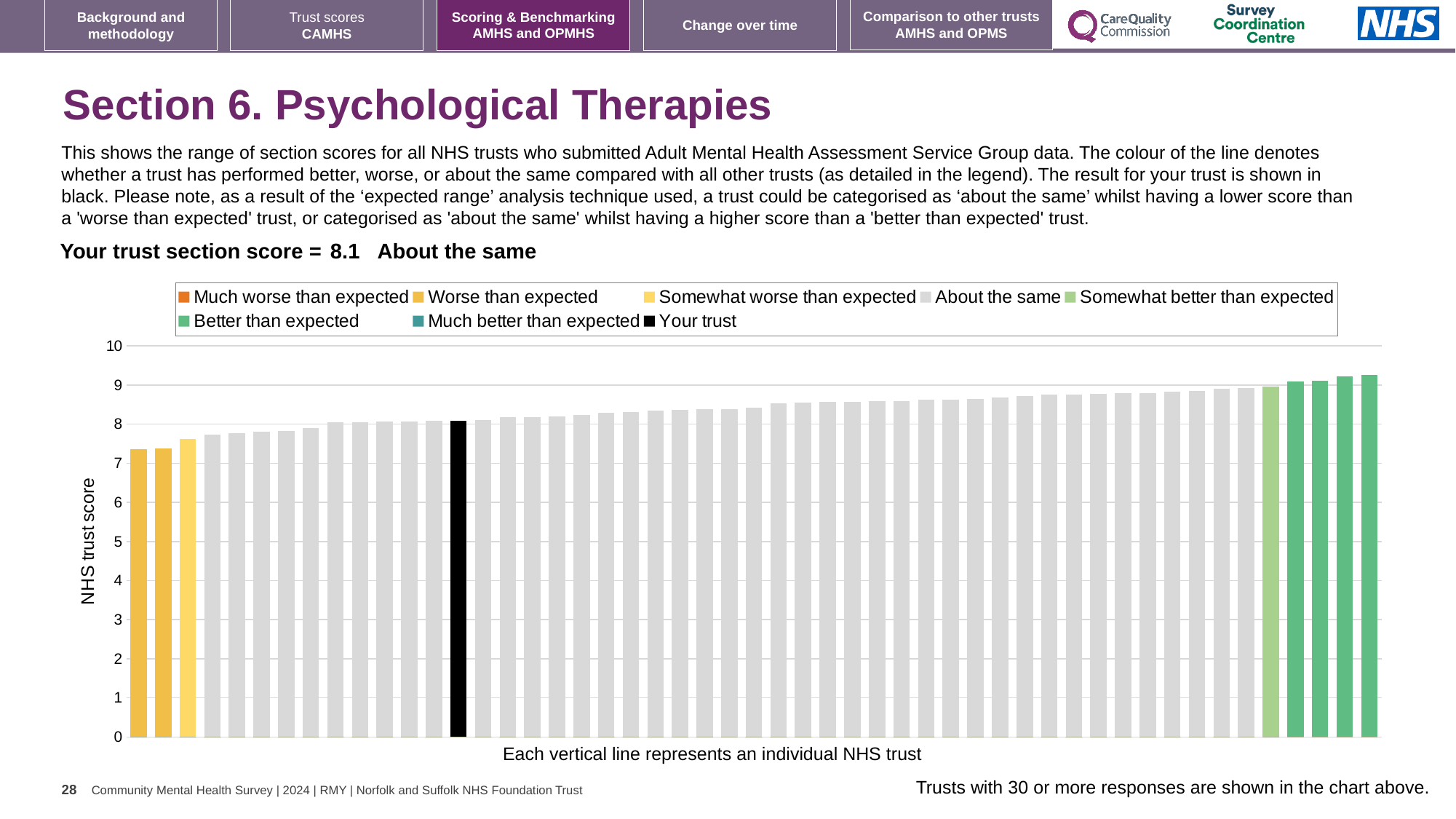
Is the value of the leftmost bar greater or less than 8? less What is the section score for your trust shown on the slide? 8.1 What kind of chart is shown on the slide? Bar chart What colour is used for the 'Your trust' bar in the chart? Black Is the value of the black 'Your trust' bar greater or less than 7? greater How many entries does the chart legend list? 8 Is the value of the rightmost bar greater or less than 9? greater What is the label on the vertical axis of the chart? NHS trust score Do the bar values rise or fall from left to right along the x axis? rise Is the black 'Your trust' bar higher or lower than the leftmost bar? higher Which category does your trust fall into according to the slide? About the same